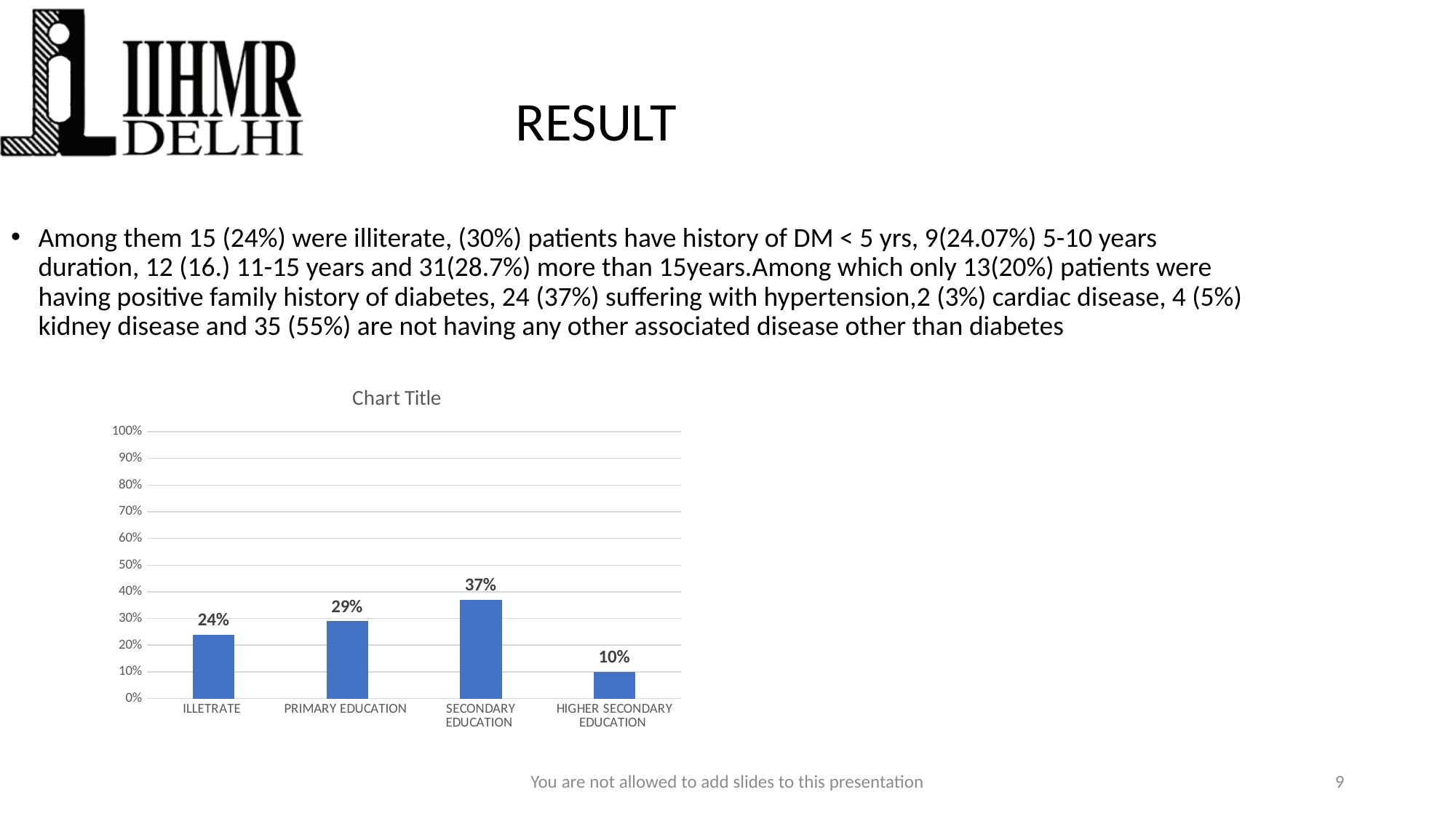
Which is larger, the value for ILLETRATE or the value for PRIMARY EDUCATION? PRIMARY EDUCATION What is the value for PRIMARY EDUCATION in the chart? 29% What is the value for SECONDARY EDUCATION in the chart? 37% Which category has the highest value in the chart? SECONDARY EDUCATION What kind of chart is shown on the slide? bar chart Is the value for SECONDARY EDUCATION greater or less than 30%? greater What is the value for ILLETRATE in the chart? 24% Which category has the lowest value in the chart? HIGHER SECONDARY EDUCATION What is the title shown above the chart? Chart Title What is the value for HIGHER SECONDARY EDUCATION in the chart? 10% What is the difference between the values for SECONDARY EDUCATION and HIGHER SECONDARY EDUCATION? 27% How many categories are shown on the x axis of the chart? 4